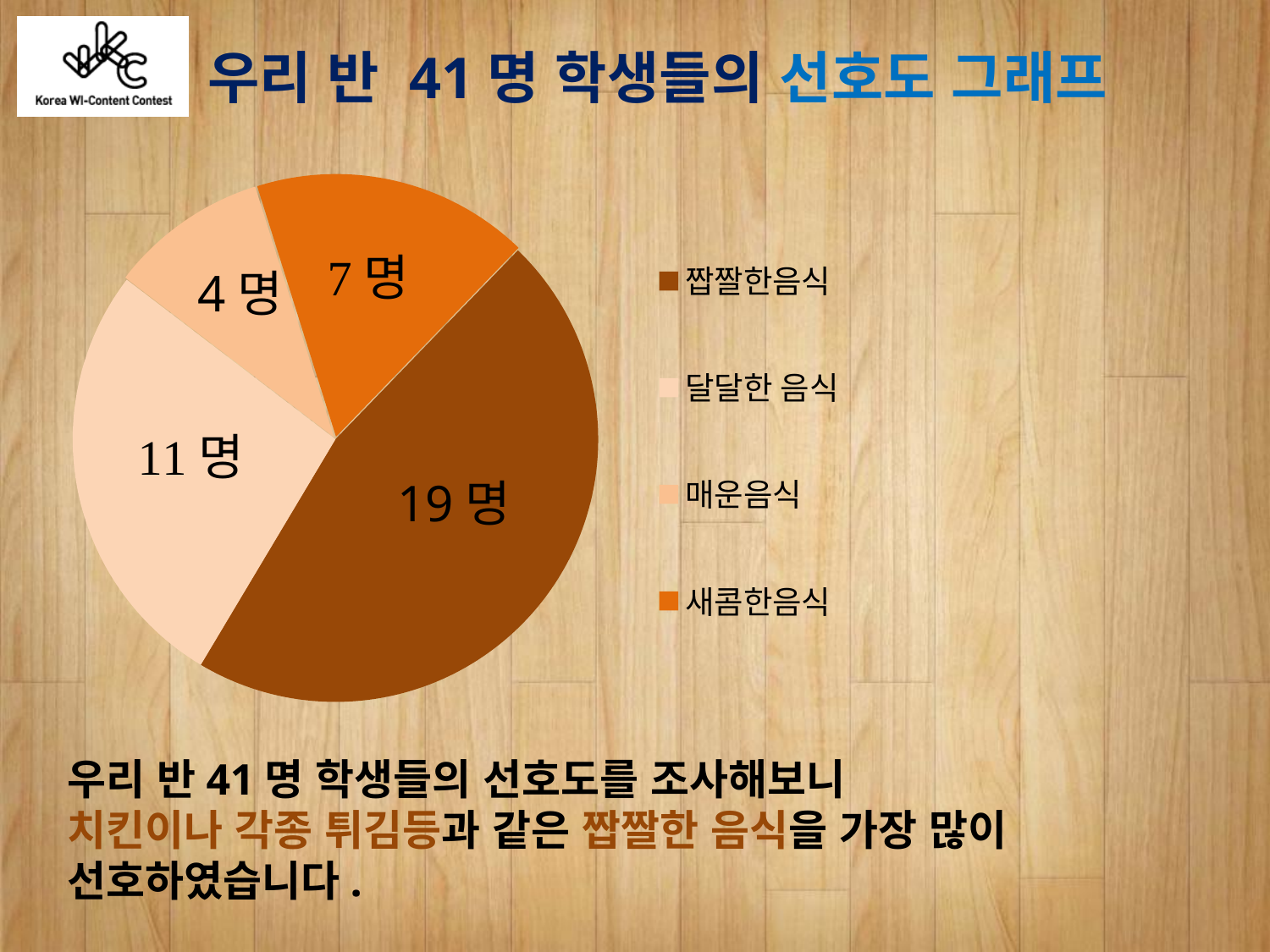
How many students chose 매운음식? 4 명 How many students chose 달달한 음식? 11 명 What is the total number of students across all slices of the pie? 41 명 Which food category has the largest slice of the pie? 짭짤한음식 How many students chose 짭짤한음식? 19 명 How many students chose 새콤한음식? 7 명 What kind of chart is shown on the slide? pie chart How many categories does the pie chart have? 4 How many more students chose 짭짤한음식 than 달달한 음식? 8 명 Which food category has the smallest slice of the pie? 매운음식 What colour is the slice for 새콤한음식? orange Which has more students, 새콤한음식 or 매운음식? 새콤한음식